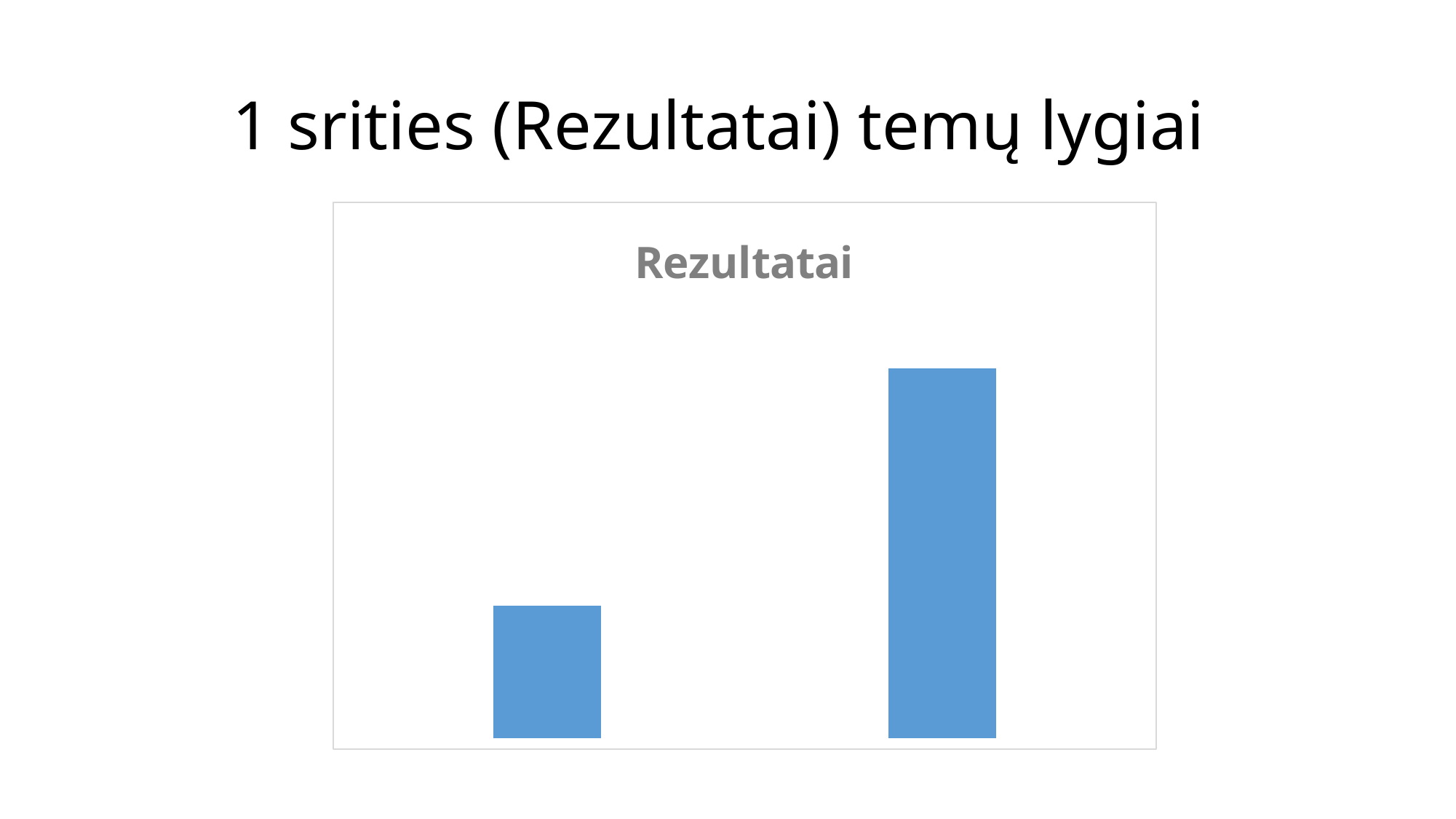
Which bar is the tallest in the chart? the right bar What kind of chart is shown on the slide? bar chart What colour are the bars in the chart? blue Do the bar values rise or fall from left to right? rise How many bars does the chart show? 2 Which bar is taller, the left one or the right one? the right one What is the title of the chart? Rezultatai Which bar is the shortest in the chart? the left bar